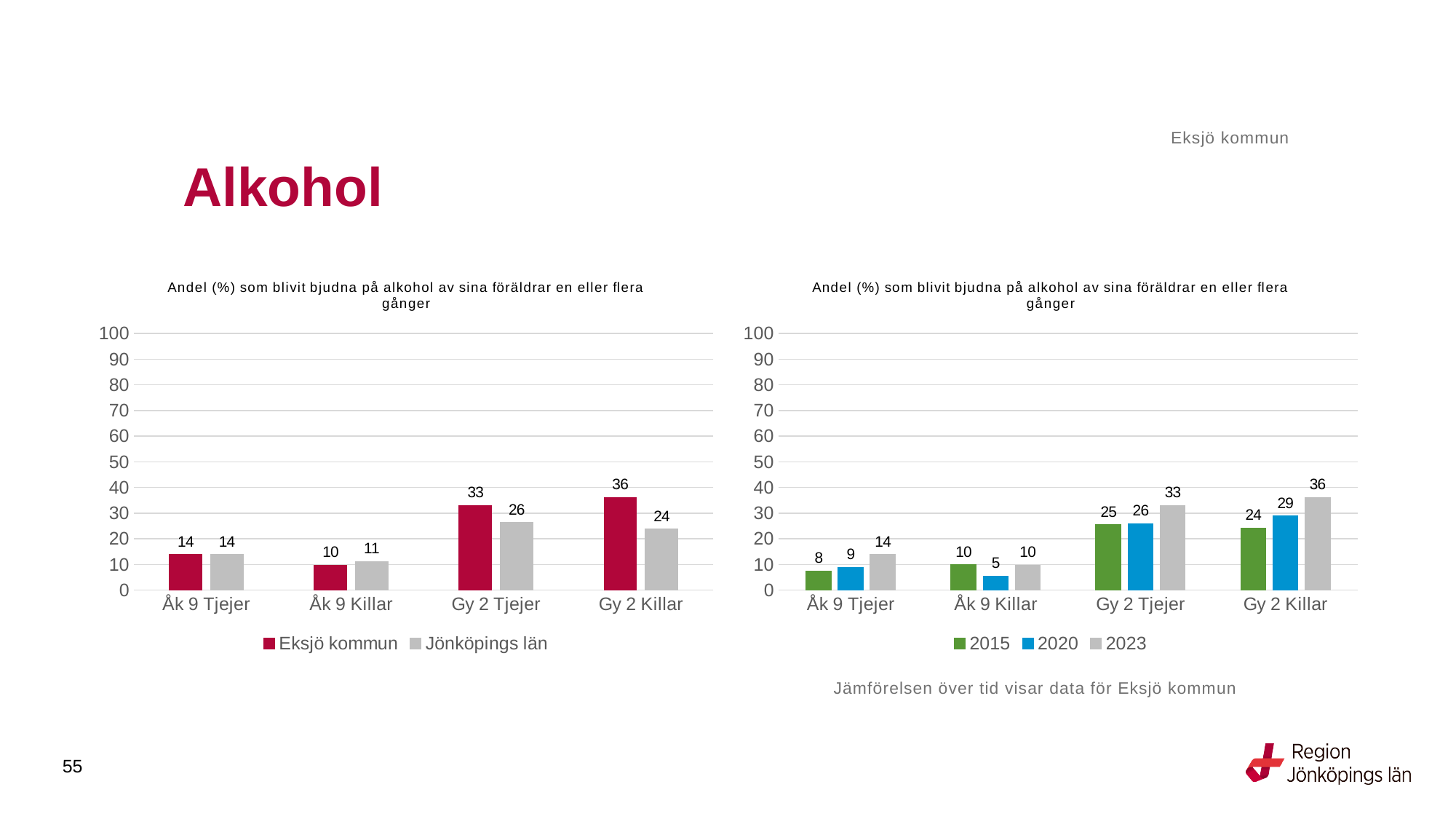
In the right chart, what is the value for 2015 for Gy 2 Tjejer? 25 In the left chart, what is the value for Jönköpings län for Åk 9 Killar? 11 In the left chart, which category has the highest value for Eksjö kommun? Gy 2 Killar In the right chart, which category has the lowest value for 2015? Åk 9 Tjejer In the right chart, what is the difference between the 2023 and 2015 values for Åk 9 Tjejer? 6 In the left chart, what is the value for Eksjö kommun for Gy 2 Killar? 36 In the right chart, what is the value for 2020 for Åk 9 Killar? 5 In the left chart, how many series does the legend list? 2 In the right chart, how many series does the legend list? 3 In the right chart, is the 2023 value for Gy 2 Killar larger or the 2015 value for Gy 2 Killar? 2023 What kind of chart is the right chart? Bar chart In the left chart, what is the difference between Eksjö kommun and Jönköpings län for Gy 2 Killar? 12